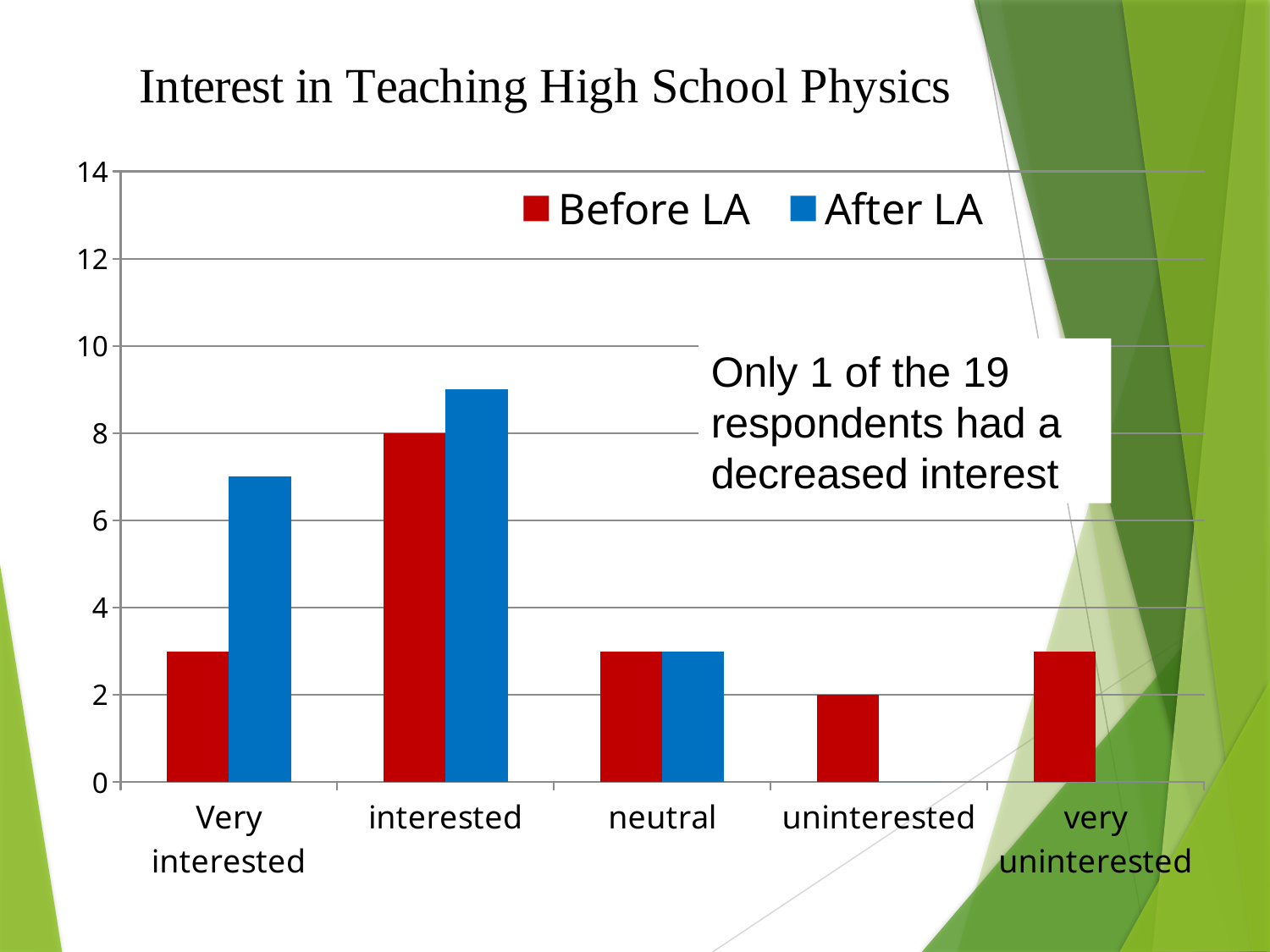
What kind of chart is shown on the slide? bar chart How many series does the legend list? 2 Is the Before LA value for 'very uninterested' greater or less than 4? less What is the difference between the Before LA values for 'interested' and 'uninterested'? 6 What is the Before LA value for the 'uninterested' category? 2 How many categories are shown on the x axis? 5 Is the After LA value for 'interested' greater or less than 8? greater Which category has the lowest Before LA value? uninterested Which category has the highest After LA value? interested Is the After LA value for 'Very interested' greater or less than 6? greater For the 'Very interested' category, which is larger: the Before LA value or the After LA value? After LA What is the Before LA value for the 'interested' category? 8